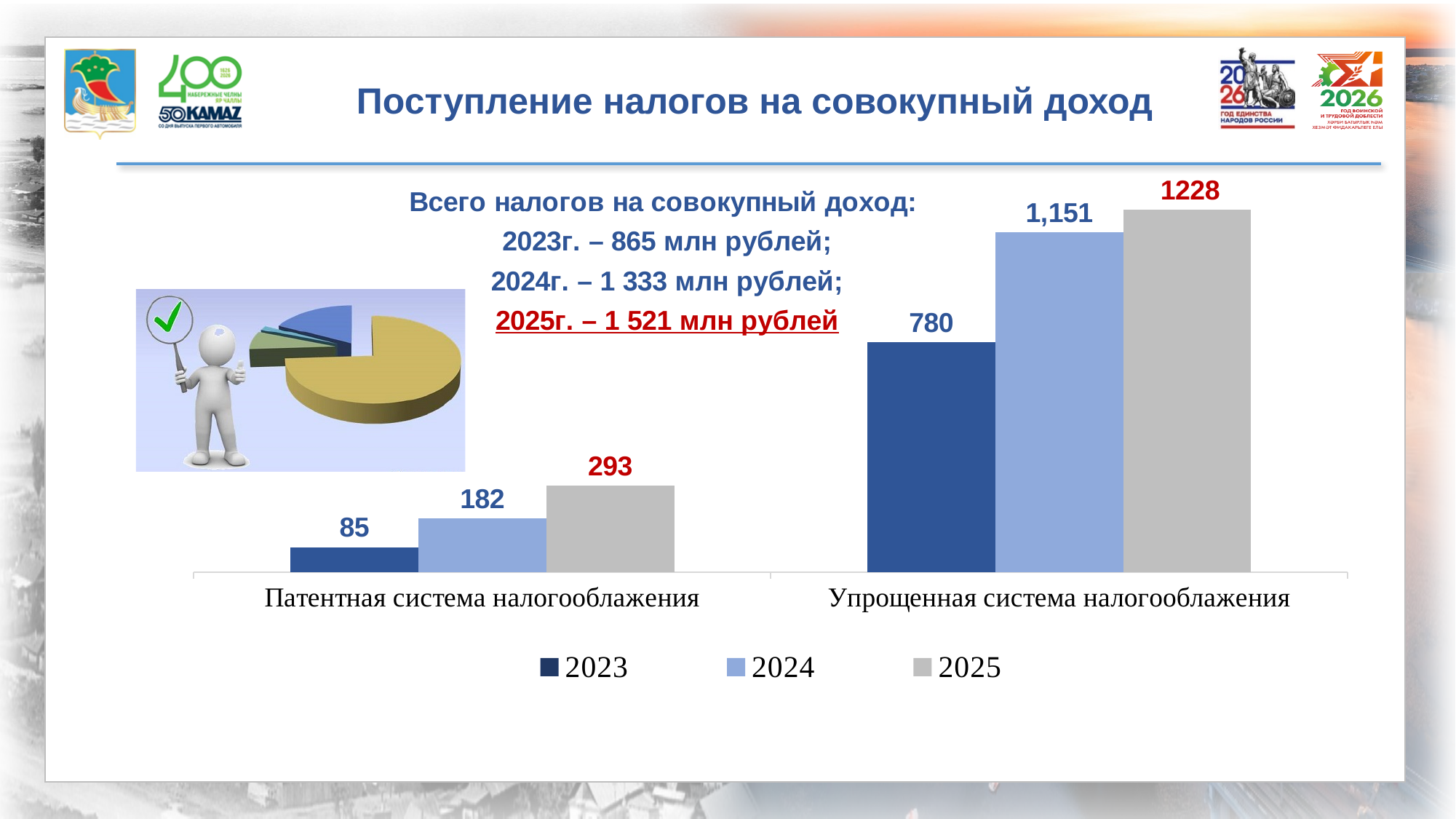
Which is larger: the 2024 value for Патентная система налогооблажения or the 2023 value for Упрощенная система налогооблажения? 2023 value for Упрощенная система налогооблажения How many series does the legend list? 3 What is the difference between the 2025 and 2023 values in the Упрощенная система налогооблажения category? 448 Do the values in the Упрощенная система налогооблажения category rise or fall from 2023 to 2025? Rise Which year has the highest value in the Упрощенная система налогооблажения category? 2025 What is the value for 2023 in the Патентная система налогооблажения category? 85 What kind of chart is shown on the slide? Bar chart What is the value for 2023 in the Упрощенная система налогооблажения category? 780 What is the difference between the 2025 and 2023 values in the Патентная система налогооблажения category? 208 What is the value for 2024 in the Упрощенная система налогооблажения category? 1,151 What is the value for 2025 in the Патентная система налогооблажения category? 293 Which year has the lowest value in the Патентная система налогооблажения category? 2023